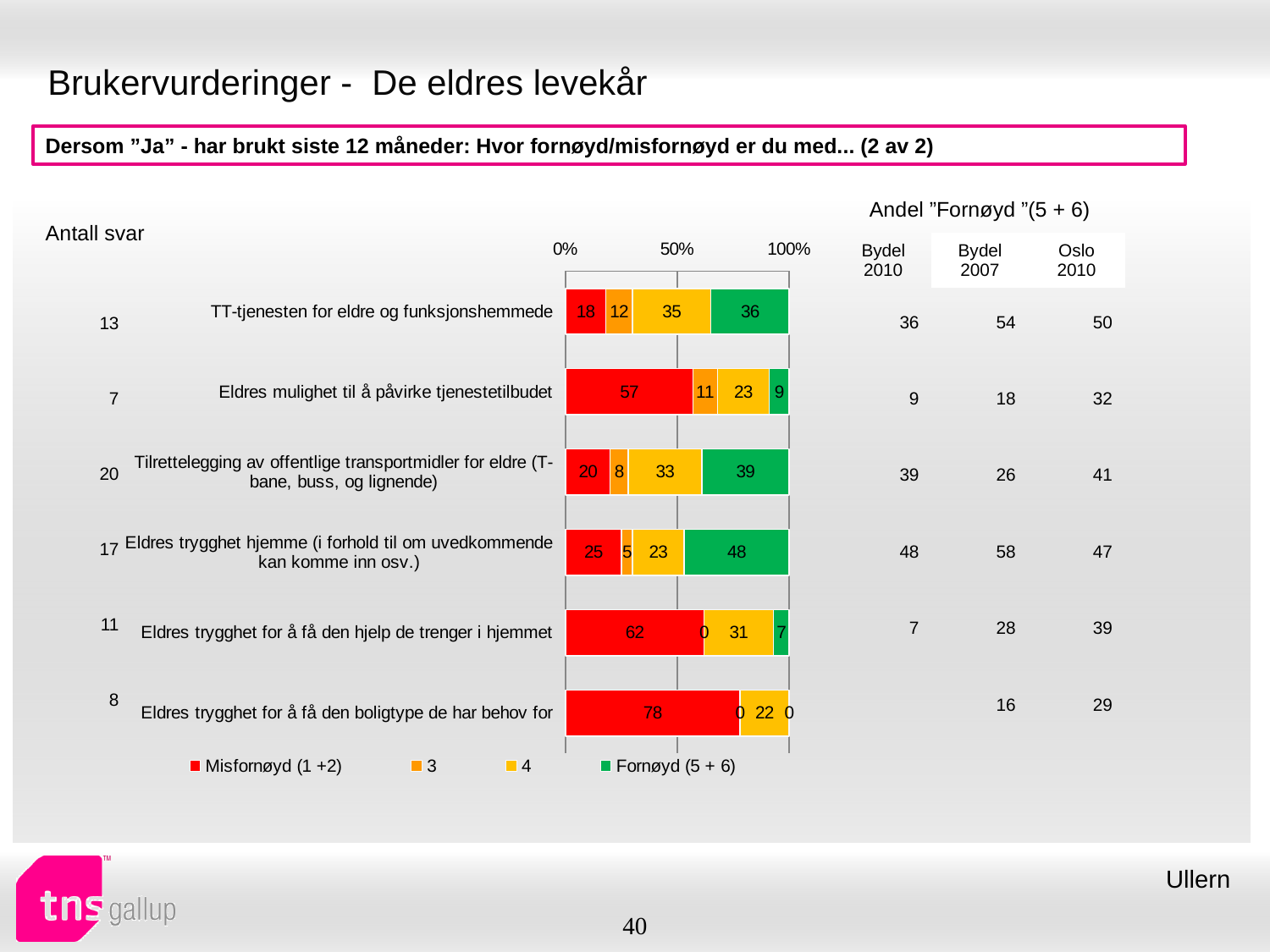
How many series does the chart legend list? 4 Which colour represents the Fornøyd (5 + 6) series in the chart? green Is the Misfornøyd (1 +2) value for "Eldres trygghet for å få den boligtype de har behov for" greater or less than 50%? greater What is the value of series "4" for "Tilrettelegging av offentlige transportmidler for eldre (T-bane, buss, og lignende)"? 33 How many categories are plotted in the chart? 6 What is the Misfornøyd (1 +2) value for "Eldres trygghet for å få den boligtype de har behov for"? 78 Which is larger: the Fornøyd (5 + 6) value for "Tilrettelegging av offentlige transportmidler for eldre (T-bane, buss, og lignende)" or for "Eldres mulighet til å påvirke tjenestetilbudet"? Tilrettelegging av offentlige transportmidler for eldre (T-bane, buss, og lignende) Which category has the highest Fornøyd (5 + 6) value? Eldres trygghet hjemme (i forhold til om uvedkommende kan komme inn osv.) What kind of chart is shown on the slide? stacked bar chart What is the Fornøyd (5 + 6) value for "TT-tjenesten for eldre og funksjonshemmede"? 36 Which category has the lowest Misfornøyd (1 +2) value? TT-tjenesten for eldre og funksjonshemmede What is the difference between the Misfornøyd (1 +2) values for "Eldres trygghet for å få den hjelp de trenger i hjemmet" and "Eldres mulighet til å påvirke tjenestetilbudet"? 5